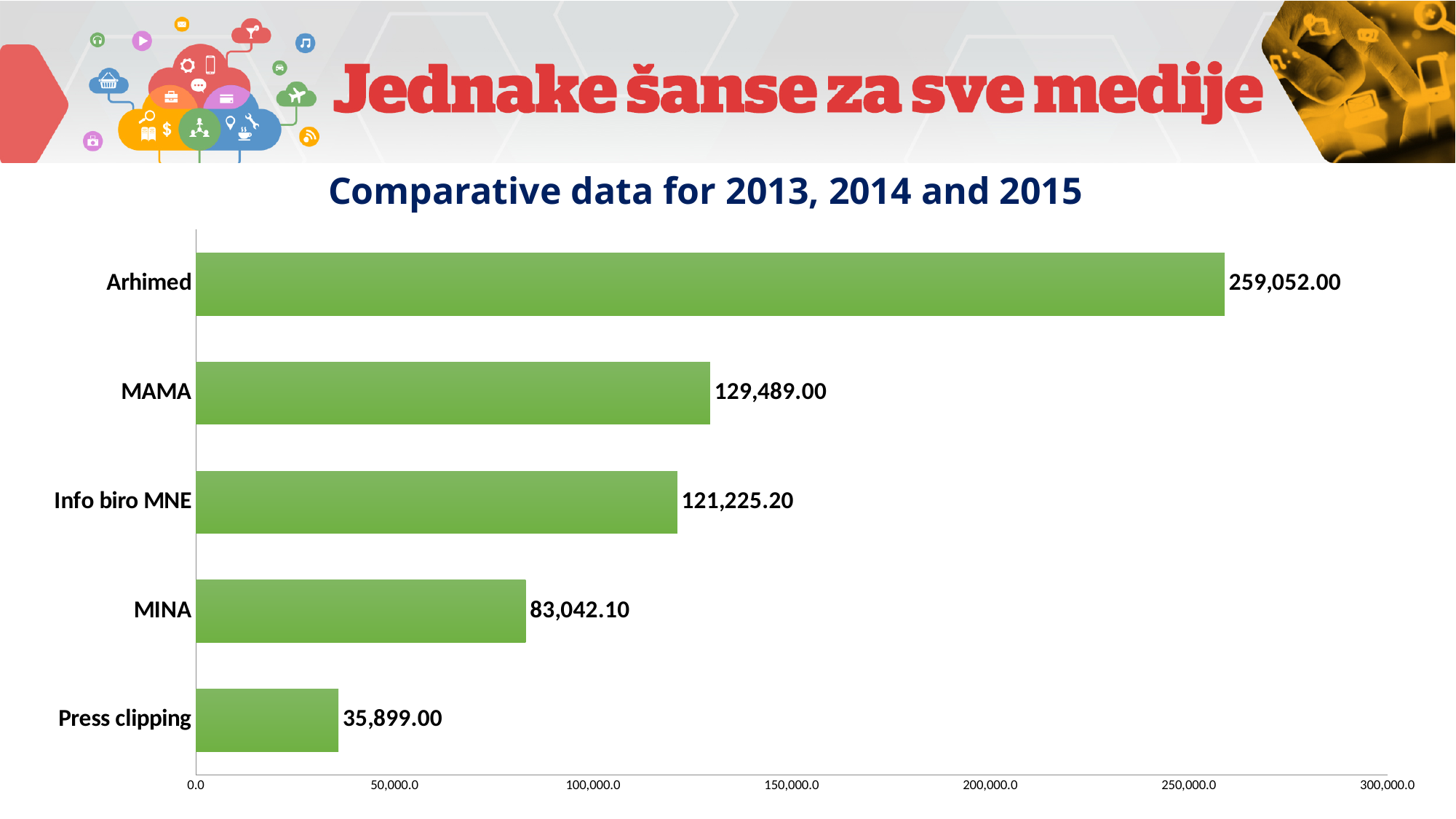
What is the value for MINA? 83,042.10 How many categories are shown in the chart? 5 What is the title of the chart? Comparative data for 2013, 2014 and 2015 Which is larger, the value for MINA or the value for Press clipping? MINA Which category has the highest value? Arhimed What is the value for Press clipping? 35,899.00 What is the value for Info biro MNE? 121,225.20 Which category has the lowest value? Press clipping What is the difference between the values for Arhimed and MAMA? 129,563.00 What is the value for MAMA? 129,489.00 What is the value for Arhimed? 259,052.00 What kind of chart is shown on the slide? Bar chart